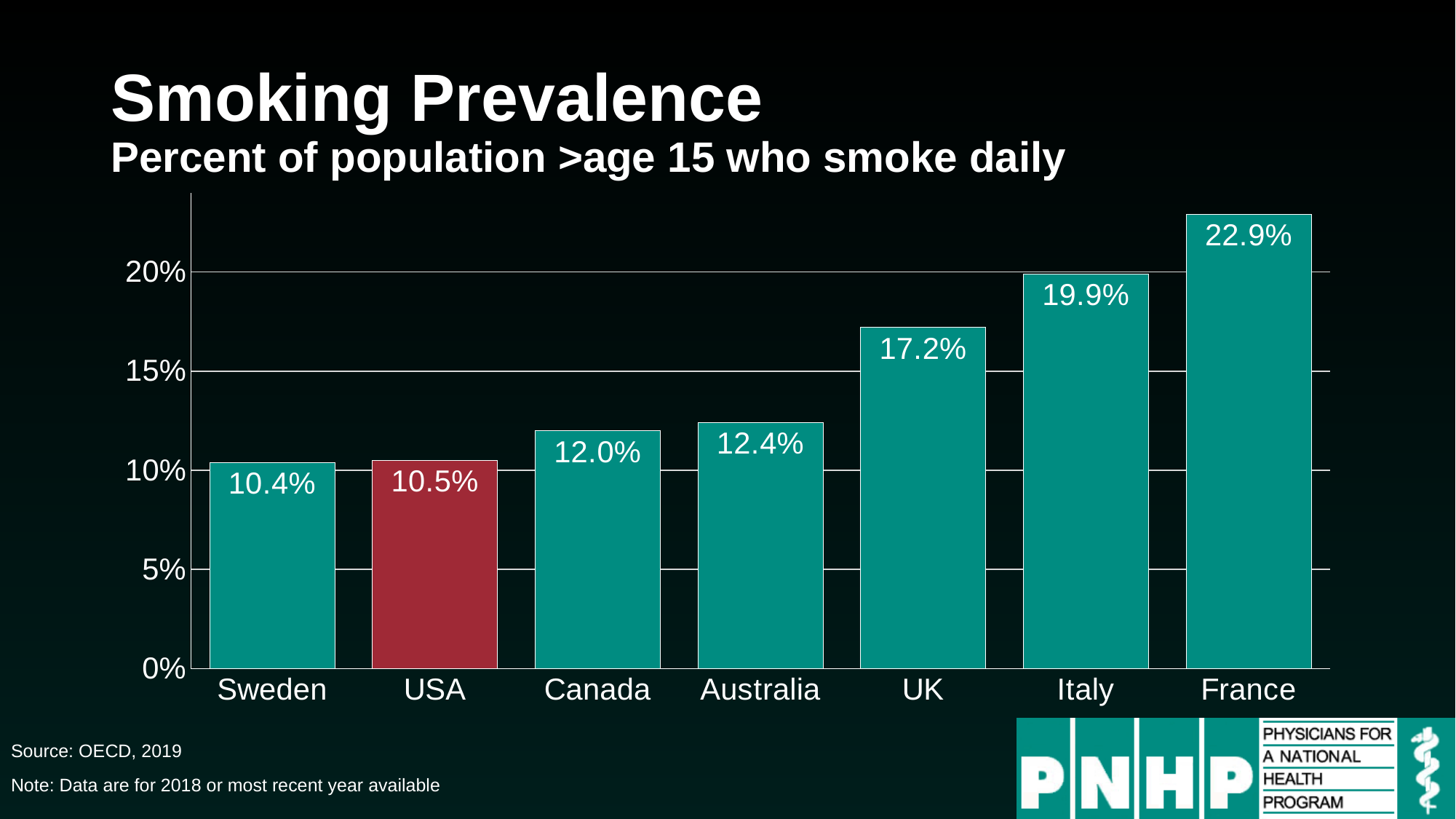
How many countries are shown in the chart? 7 What is the smoking prevalence for France? 22.9% What is the smoking prevalence for Australia? 12.4% What is the difference in smoking prevalence between France and the USA? 12.4% What kind of chart is shown on the slide? Bar chart Which country has the lowest smoking prevalence? Sweden Which has a higher smoking prevalence, Canada or the UK? UK Which country's bar is shown in a different colour (red) from the others? USA What is the smoking prevalence for the USA? 10.5% What is the difference in smoking prevalence between Italy and the UK? 2.7% Is the value for Italy greater or less than 15%? greater Which country has the highest smoking prevalence? France